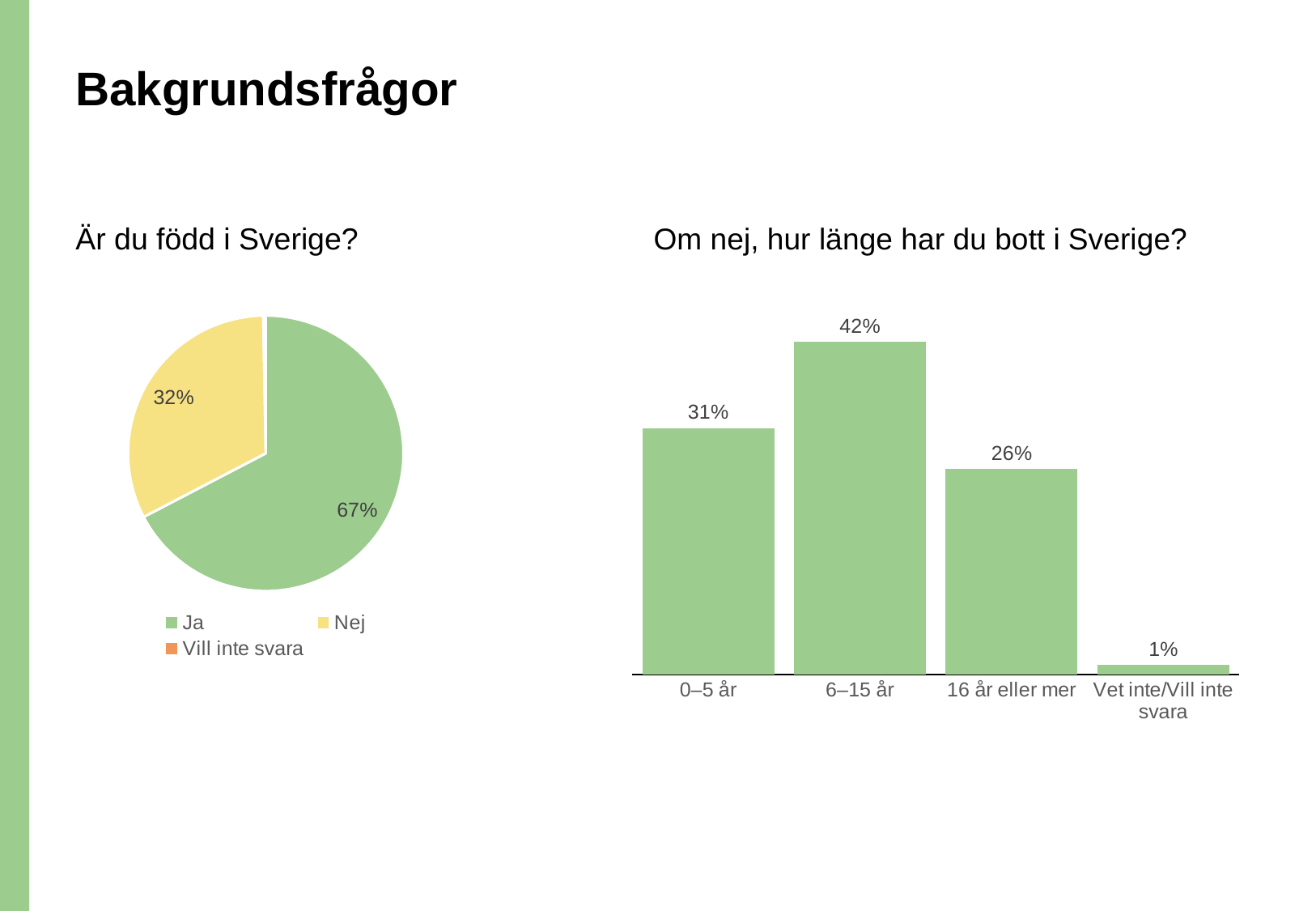
In the pie chart 'Är du född i Sverige?', what share of respondents answered 'Ja'? 67% How many categories are shown in the chart 'Om nej, hur länge har du bott i Sverige?'? 4 In the pie chart 'Är du född i Sverige?', which answer has the largest slice? Ja In the chart 'Om nej, hur länge har du bott i Sverige?', which category has the lowest value? Vet inte/Vill inte svara In the chart 'Om nej, hur länge har du bott i Sverige?', what is the value for '6–15 år'? 42% In the chart 'Om nej, hur länge har du bott i Sverige?', what is the value for '16 år eller mer'? 26% In the pie chart 'Är du född i Sverige?', how many entries does the legend list? 3 What kind of chart is the chart on the left, 'Är du född i Sverige?'? Pie chart In the chart 'Om nej, hur länge har du bott i Sverige?', what is the difference between the values for '6–15 år' and '0–5 år'? 11 percentage points In the chart 'Om nej, hur länge har du bott i Sverige?', which is larger: the value for '0–5 år' or for '16 år eller mer'? 0–5 år In the chart 'Om nej, hur länge har du bott i Sverige?', which category has the highest value? 6–15 år In the pie chart 'Är du född i Sverige?', what share of respondents answered 'Nej'? 32%